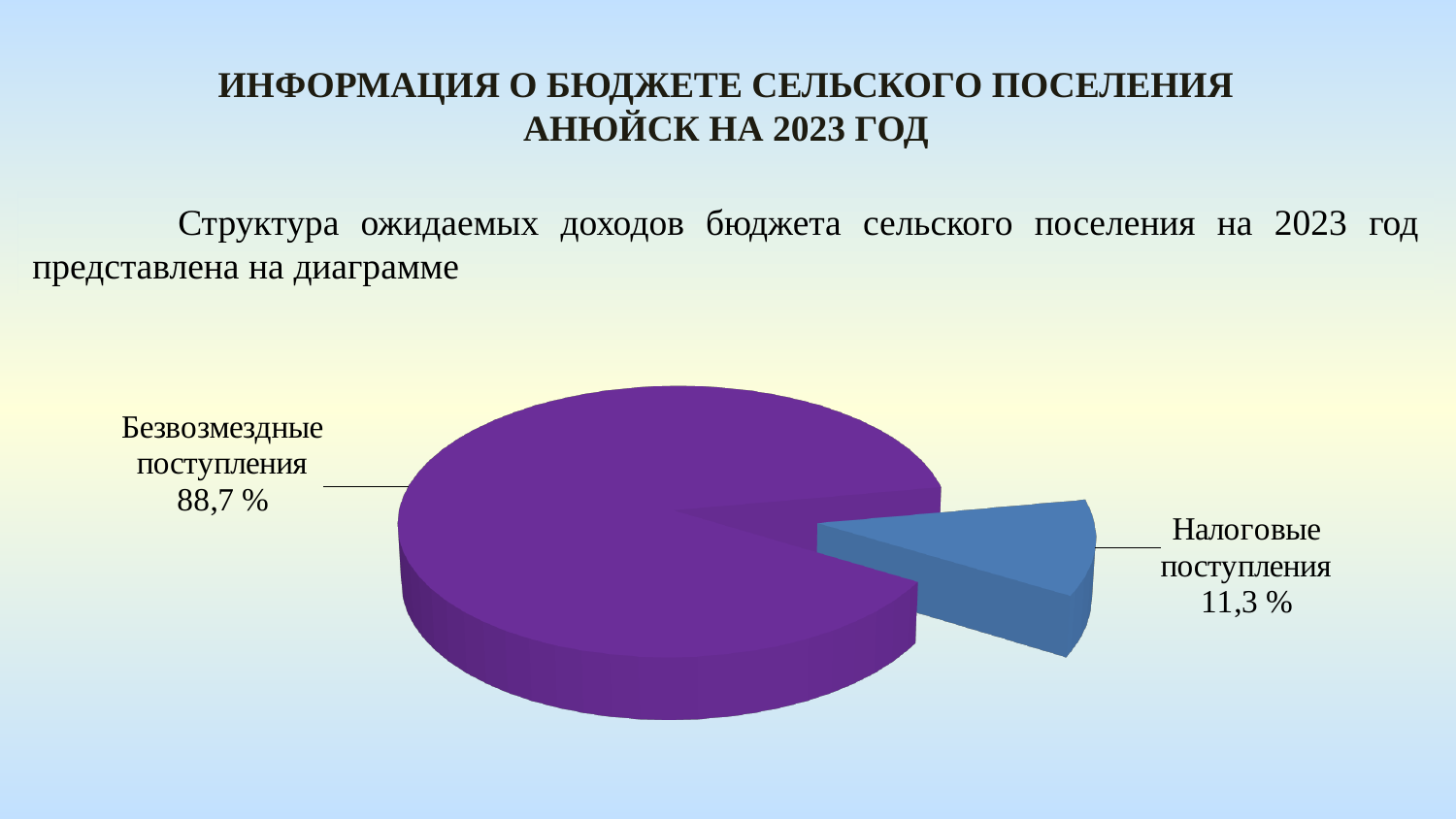
What share of the pie does Безвозмездные поступления have? 88,7 % What kind of chart is shown on the slide? Pie chart Which is larger: Безвозмездные поступления or Налоговые поступления? Безвозмездные поступления What is the difference in percentage points between Безвозмездные поступления and Налоговые поступления? 77,4 % What colour is the slice for Безвозмездные поступления? Purple What share of the pie does Налоговые поступления have? 11,3 % How many slices does the pie chart have? 2 Which slice of the pie is the smallest? Налоговые поступления Which slice of the pie is the largest? Безвозмездные поступления What colour is the slice for Налоговые поступления? Blue